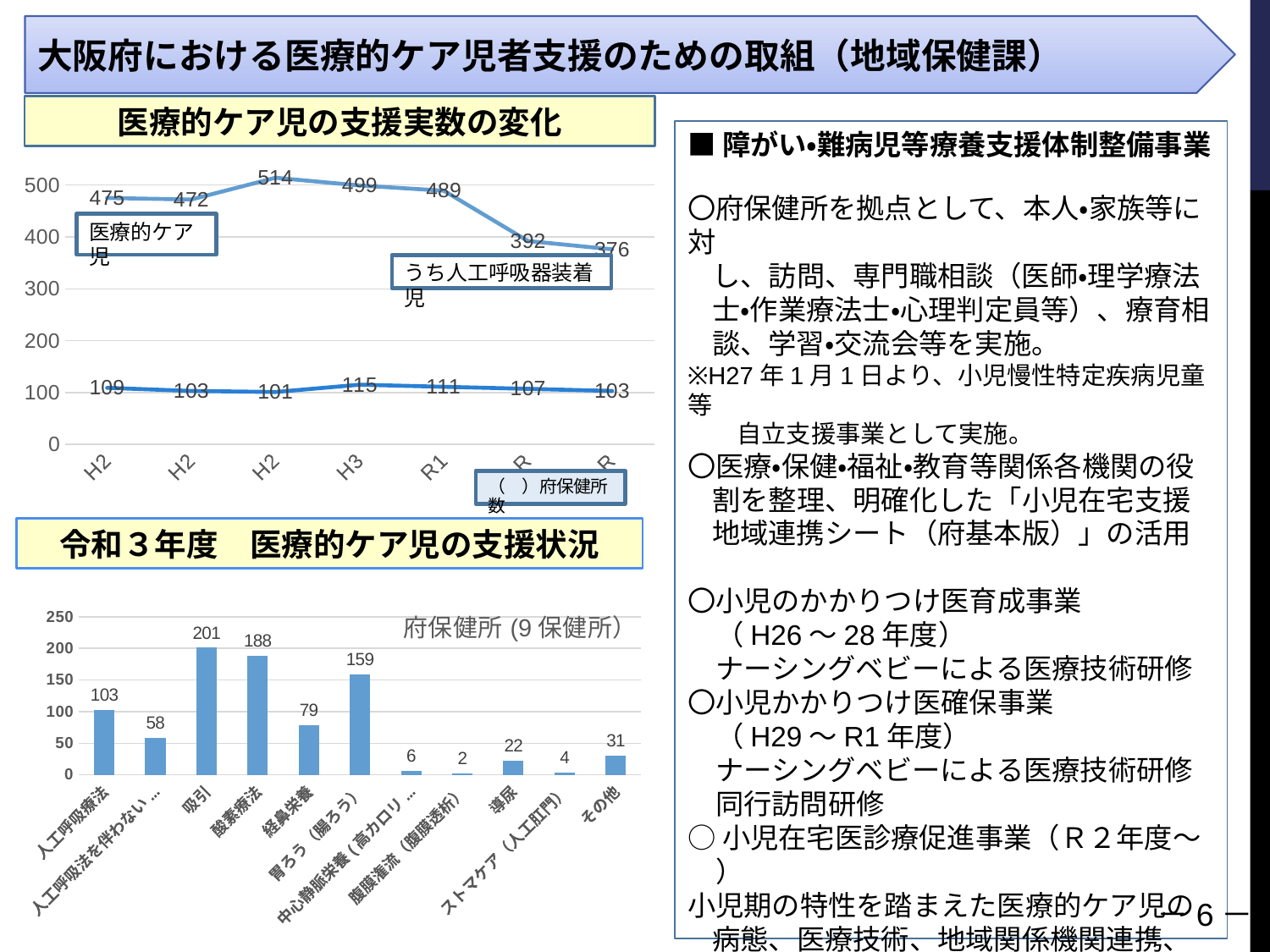
In the bottom chart (令和３年度 医療的ケア児の支援状況), which category has the lowest value? 腹膜潅流（腹膜透析） What kind of chart is the top chart (医療的ケア児の支援実数の変化)? line chart In the bottom chart (令和３年度 医療的ケア児の支援状況), what is the difference between the values for 吸引 and 酸素療法? 13 In the bottom chart (令和３年度 医療的ケア児の支援状況), which category has the highest value? 吸引 In the bottom chart (令和３年度 医療的ケア児の支援状況), what is the value for 吸引? 201 In the top chart (医療的ケア児の支援実数の変化), what is the difference between the first and last values of the 医療的ケア児 line? 99 In the bottom chart (令和３年度 医療的ケア児の支援状況), which is larger, the value for 人工呼吸療法 or the value for 経鼻栄養? 人工呼吸療法 In the top chart (医療的ケア児の支援実数の変化), what is the last (rightmost) value of the うち人工呼吸器装着児 line? 103 How many categories are shown in the bottom chart (令和３年度 医療的ケア児の支援状況)? 11 In the bottom chart (令和３年度 医療的ケア児の支援状況), what is the value for 酸素療法? 188 What kind of chart is the bottom chart (令和３年度 医療的ケア児の支援状況)? bar chart In the top chart (医療的ケア児の支援実数の変化), what is the highest value of the 医療的ケア児 line? 514